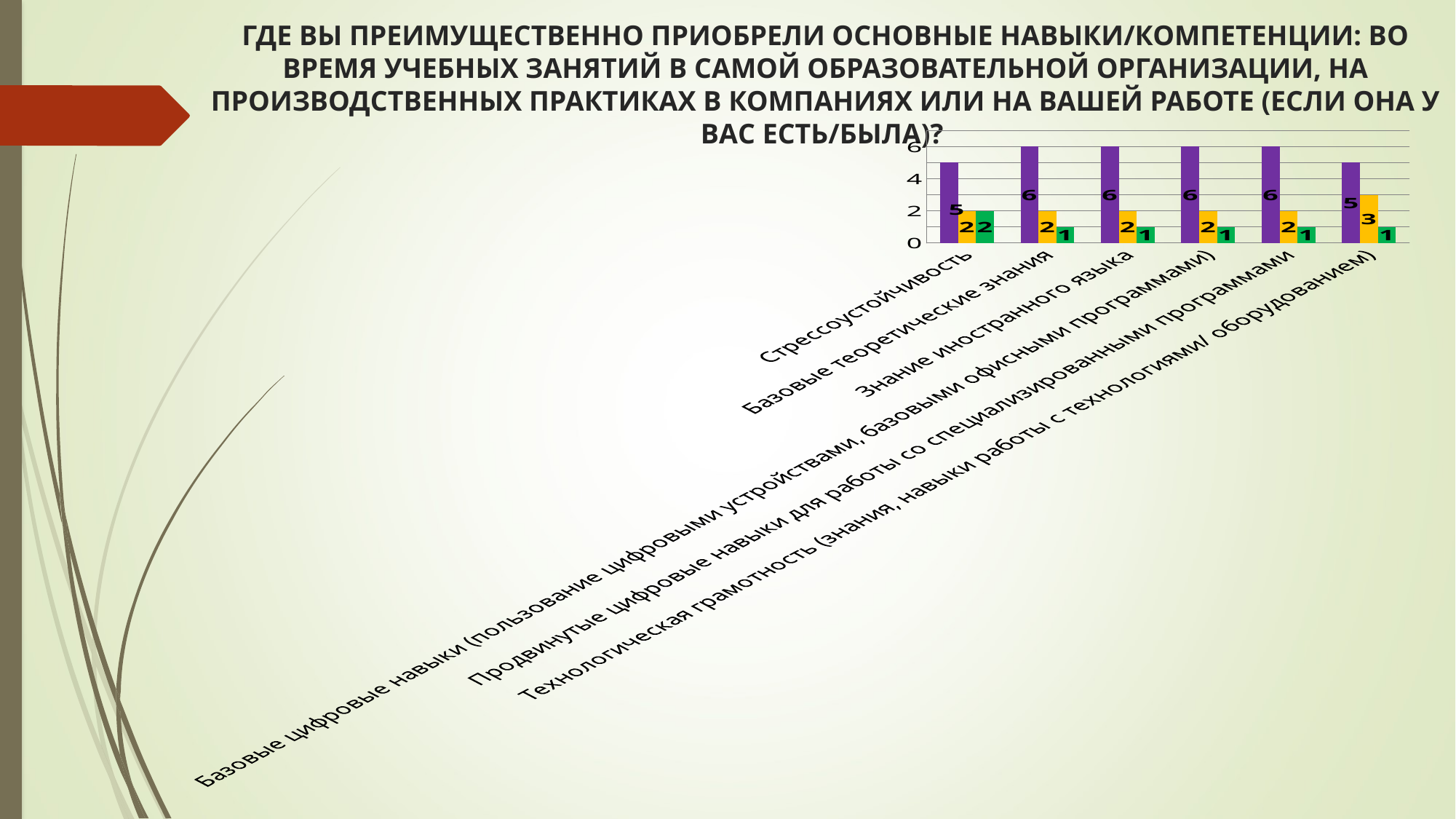
What is the difference between the purple bar and the yellow bar for Базовые теоретические знания? 4 What is the value of the purple bar for Знание иностранного языка? 6 What is the highest value shown on the vertical axis of the chart? 6 How many categories are shown on the x axis of the chart? 6 What is the total of the three bars for Стрессоустойчивость? 9 What is the value of the green bar for Стрессоустойчивость? 2 What is the value of the green bar for Базовые теоретические знания? 1 What is the value of the purple bar for Стрессоустойчивость? 5 Which category has the highest yellow bar? Технологическая грамотность What kind of chart is shown on the slide? bar chart Which is larger for Технологическая грамотность: the purple bar or the yellow bar? the purple bar What is the value of the yellow bar for Технологическая грамотность? 3